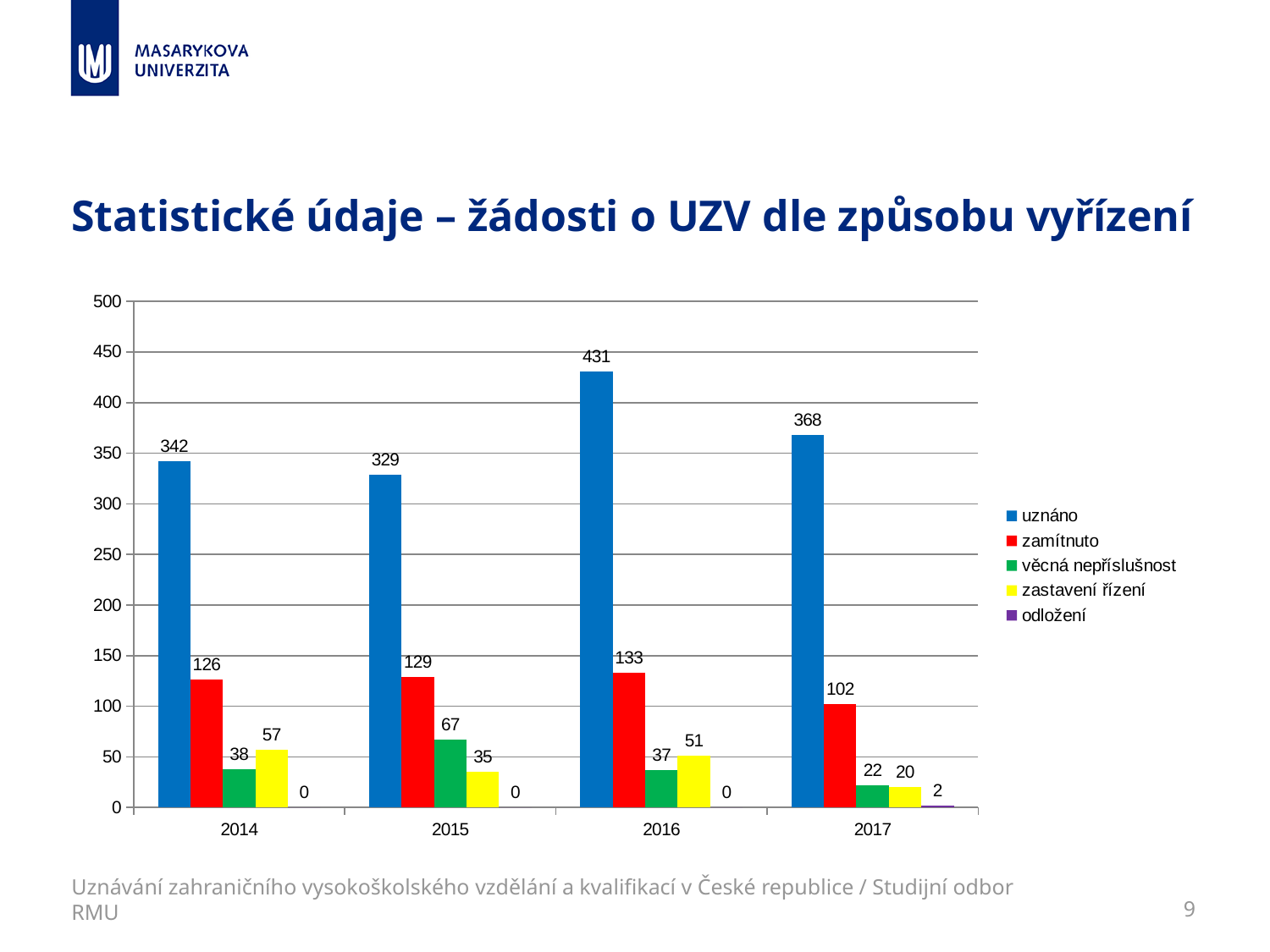
In which year is the věcná nepříslušnost value lowest? 2017 What is the value for odložení in 2017? 2 What kind of chart is shown on the slide? bar chart What is the difference between the uznáno values for 2016 and 2017? 63 In which year is the uznáno value highest? 2016 What is the value for zamítnuto in 2017? 102 How many years are shown on the x axis? 4 What is the value for uznáno in 2016? 431 What is the value for zastavení řízení in 2014? 57 Which is larger, zamítnuto in 2015 or zamítnuto in 2016? zamítnuto in 2016 How many series does the legend list? 5 Which colour represents zastavení řízení in the legend? yellow